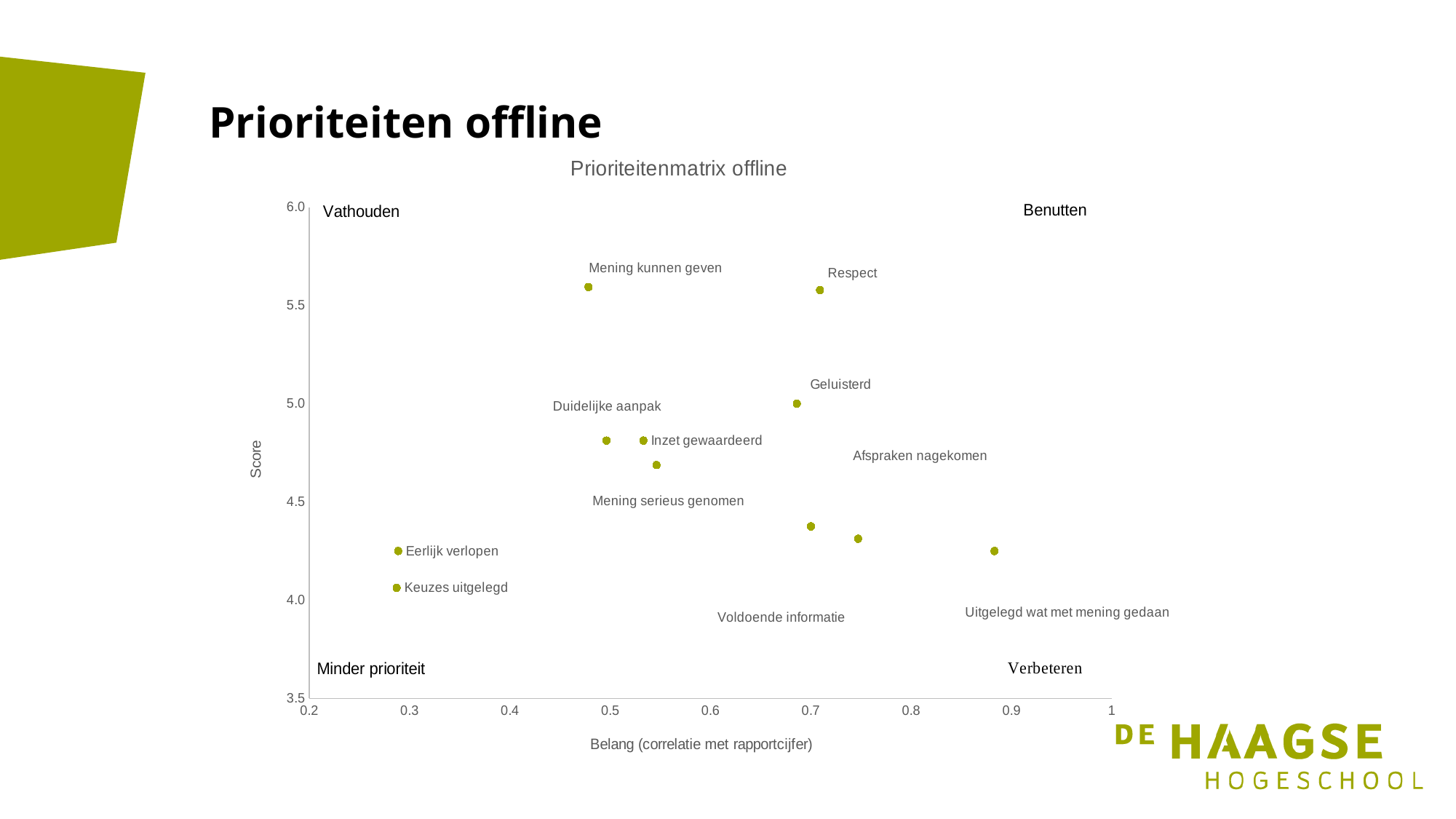
What is the title of the chart? Prioriteitenmatrix offline What is the label of the vertical axis? Score What kind of chart is shown on the slide? scatter chart Is the score for Keuzes uitgelegd greater or less than 4.5? less Which has a higher score, Mening kunnen geven or Keuzes uitgelegd? Mening kunnen geven Which point has the highest value on the Belang axis? Uitgelegd wat met mening gedaan Which point has the lowest score? Keuzes uitgelegd Is the Belang value for Eerlijk verlopen greater or less than 0.4? less Which has a higher Belang value, Respect or Duidelijke aanpak? Respect Is the Belang value for Uitgelegd wat met mening gedaan greater or less than 0.8? greater How many data points are plotted in the chart? 11